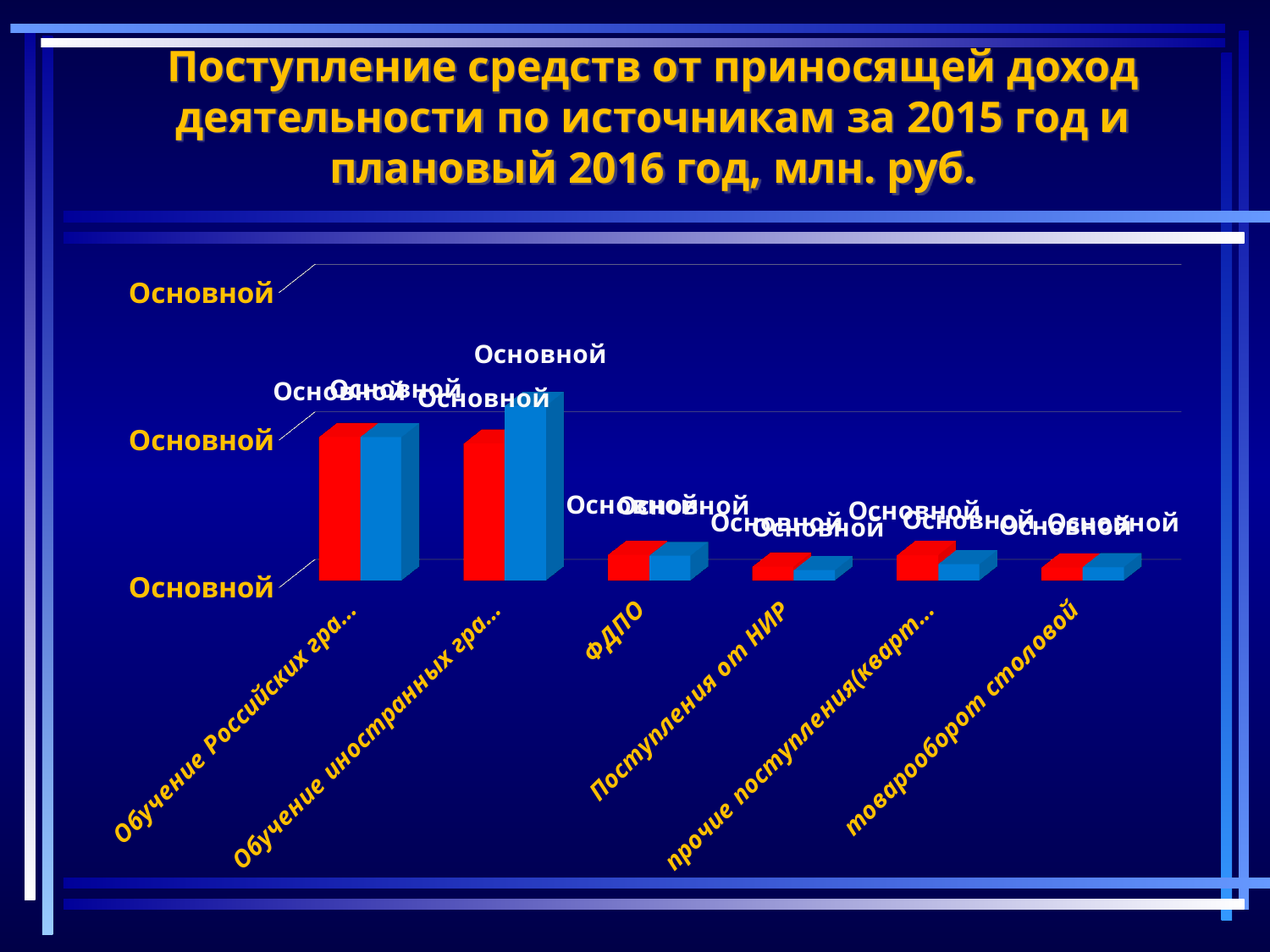
What is the title of the slide containing the chart? Поступление средств от приносящей доход деятельности по источникам за 2015 год и плановый 2016 год, млн. руб. Which category has the lowest bars in the chart? Поступления от НИР How many categories are shown along the x axis of the chart? 6 Which category has taller bars, Обучение Российских гра... or ФДПО? Обучение Российских гра... What two colours are used for the bars in the chart? red and blue Which category has taller bars, ФДПО or Поступления от НИР? ФДПО What kind of chart is shown on the slide? bar chart Which category has the tallest bar in the chart? Обучение иностранных гра... What is the label of the last category on the x axis of the chart? товарооборот столовой How many bars are plotted for each category in the chart? 2